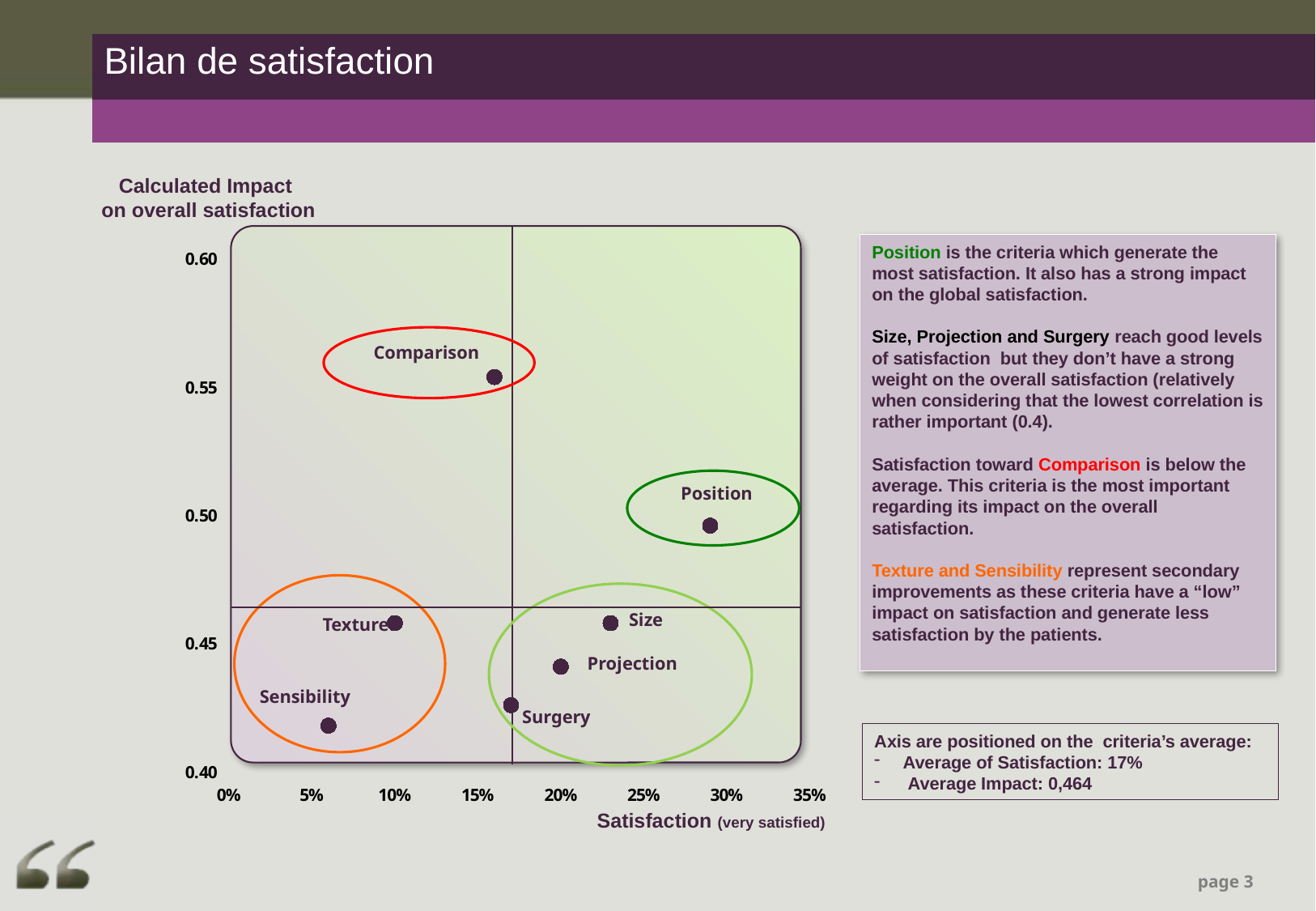
How many criteria are plotted as points on the chart? 7 Is the satisfaction value for Comparison greater or less than 20%? less Which criterion has the lowest satisfaction (very satisfied) percentage? Sensibility Is the calculated impact value for Sensibility greater or less than 0.45? less What is the label of the horizontal axis of the chart? Satisfaction (very satisfied) What kind of chart is shown on the slide? scatter chart Which criterion has the lowest calculated impact on overall satisfaction? Sensibility Which has a higher calculated impact on overall satisfaction, Comparison or Position? Comparison Which criterion has the highest satisfaction (very satisfied) percentage? Position Is the satisfaction value for Position greater or less than 25%? greater Which has a higher satisfaction percentage, Position or Comparison? Position Which criterion has the highest calculated impact on overall satisfaction? Comparison